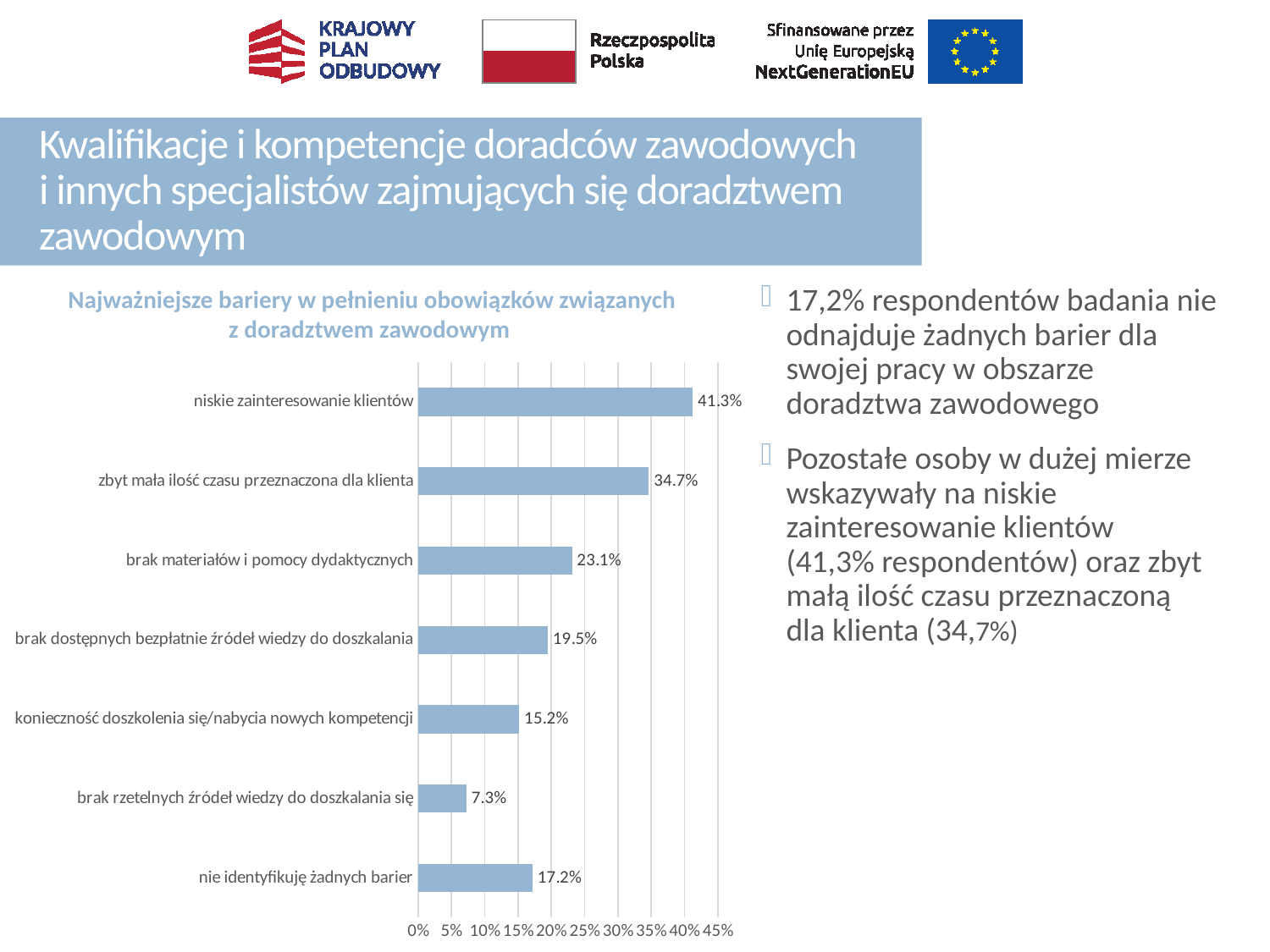
Which category has the highest value? niskie zainteresowanie klientów Which is larger: the value for 'brak dostępnych bezpłatnie źródeł wiedzy do doszkalania' or 'konieczność doszkolenia się/nabycia nowych kompetencji'? brak dostępnych bezpłatnie źródeł wiedzy do doszkalania What is the value for 'niskie zainteresowanie klientów'? 41.3% What is the difference between the values for 'niskie zainteresowanie klientów' and 'zbyt mała ilość czasu przeznaczona dla klienta'? 6.6% What is the value for 'nie identyfikuję żadnych barier'? 17.2% Is the value for 'brak rzetelnych źródeł wiedzy do doszkalania się' greater or less than 10%? less What kind of chart is shown on the slide? bar chart How many categories are shown in the chart? 7 What is the title of the chart? Najważniejsze bariery w pełnieniu obowiązków związanych z doradztwem zawodowym What is the difference between the values for 'konieczność doszkolenia się/nabycia nowych kompetencji' and 'brak rzetelnych źródeł wiedzy do doszkalania się'? 7.9% Which category has the lowest value? brak rzetelnych źródeł wiedzy do doszkalania się What is the value for 'brak materiałów i pomocy dydaktycznych'? 23.1%